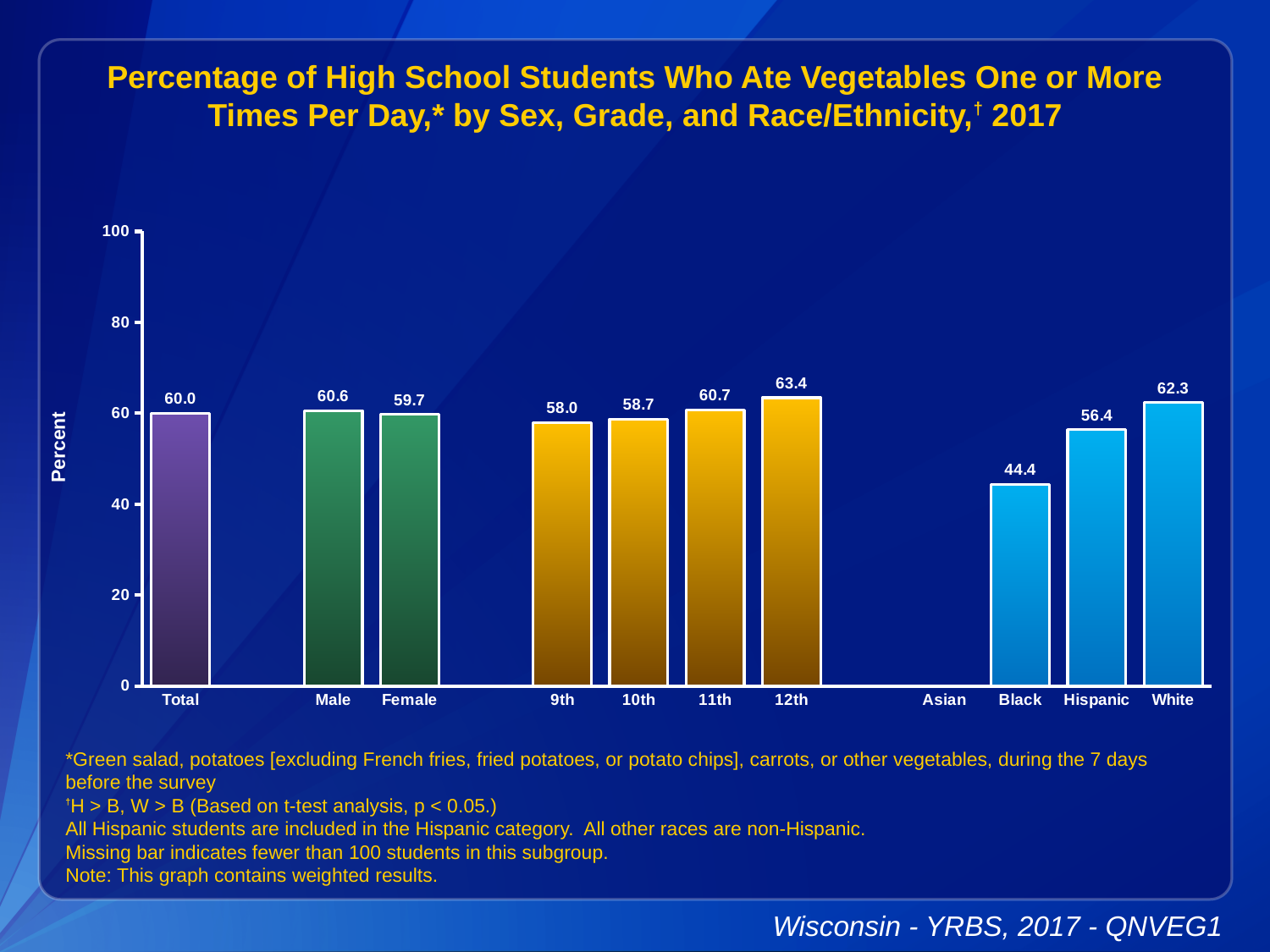
What is the value for 12th grade? 63.4 What is the difference between the values for White and Black? 17.9 What is the difference between the values for Male and Female? 0.9 Which is larger, the value for Hispanic or the value for White? White What is the value for Female? 59.7 Which category has the lowest value among the bars shown? Black Which category has the highest value? 12th Do the values rise or fall from 9th grade to 12th grade? rise What kind of chart is shown on the slide? bar chart What is the value for Black students? 44.4 What is the value for Total? 60.0 Is the value for Black greater or less than 60? less